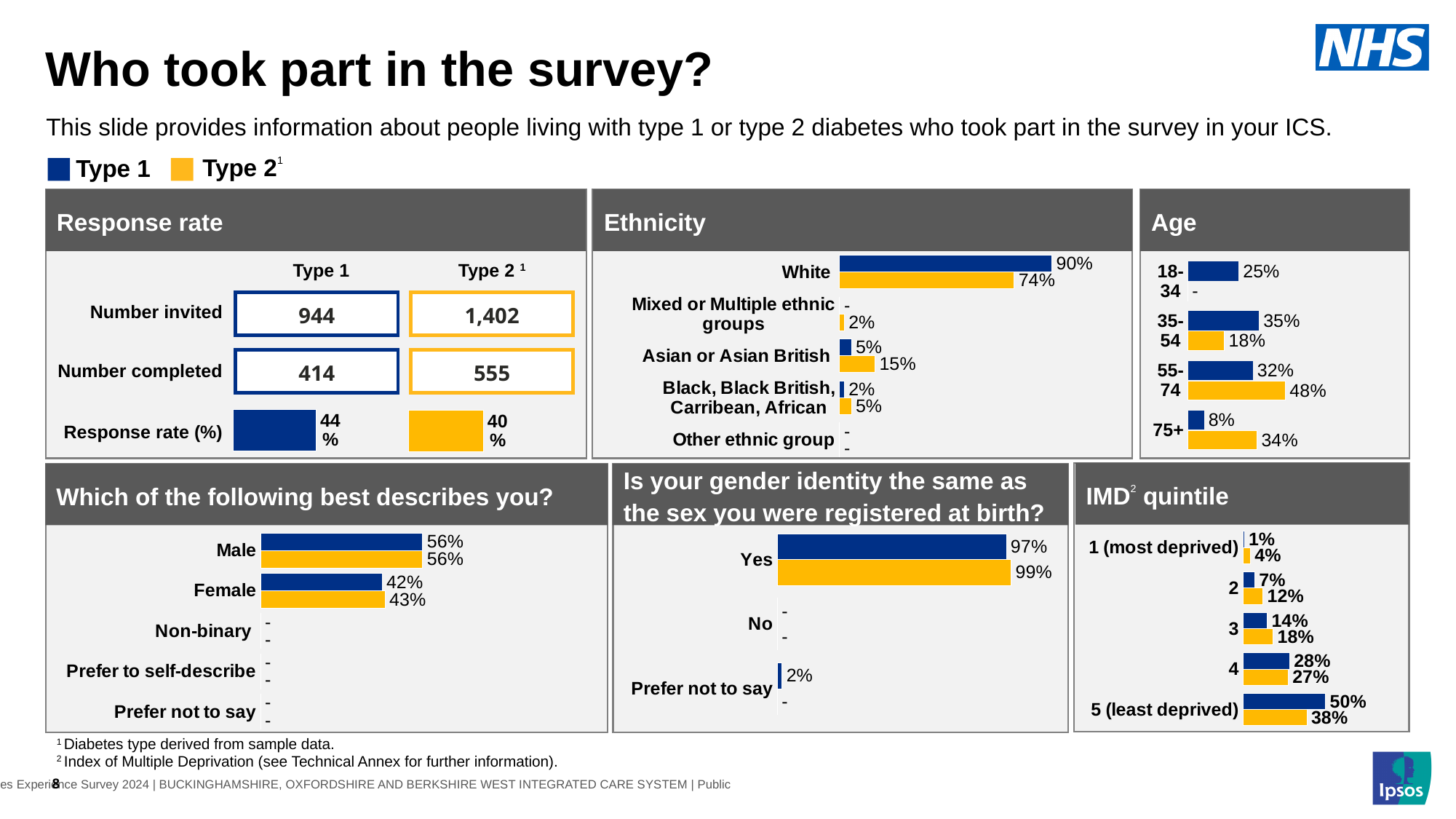
In the Age chart, which age group has the highest Type 2 value? 55-74 In the 'Which of the following best describes you?' chart, what is the Type 2 value for Female? 43% In the Ethnicity chart, what is the Type 1 value for White? 90% In the Ethnicity chart, what is the Type 2 value for Asian or Asian British? 15% In the IMD quintile chart, what is the difference between the Type 1 and Type 2 values for 5 (least deprived)? 12% In the Response rate chart, what is the number completed for Type 2? 555 In the Age chart, what is the difference between the Type 2 and Type 1 values for 75+? 26% In the 'Which of the following best describes you?' chart, how many categories are listed? 5 In the Response rate chart, which type has the higher response rate (%), Type 1 or Type 2? Type 1 In the gender identity chart, what is the Type 2 value for Yes? 99% In the IMD quintile chart, which quintile has the lowest Type 1 value? 1 (most deprived) What kind of chart is the Age chart? Bar chart